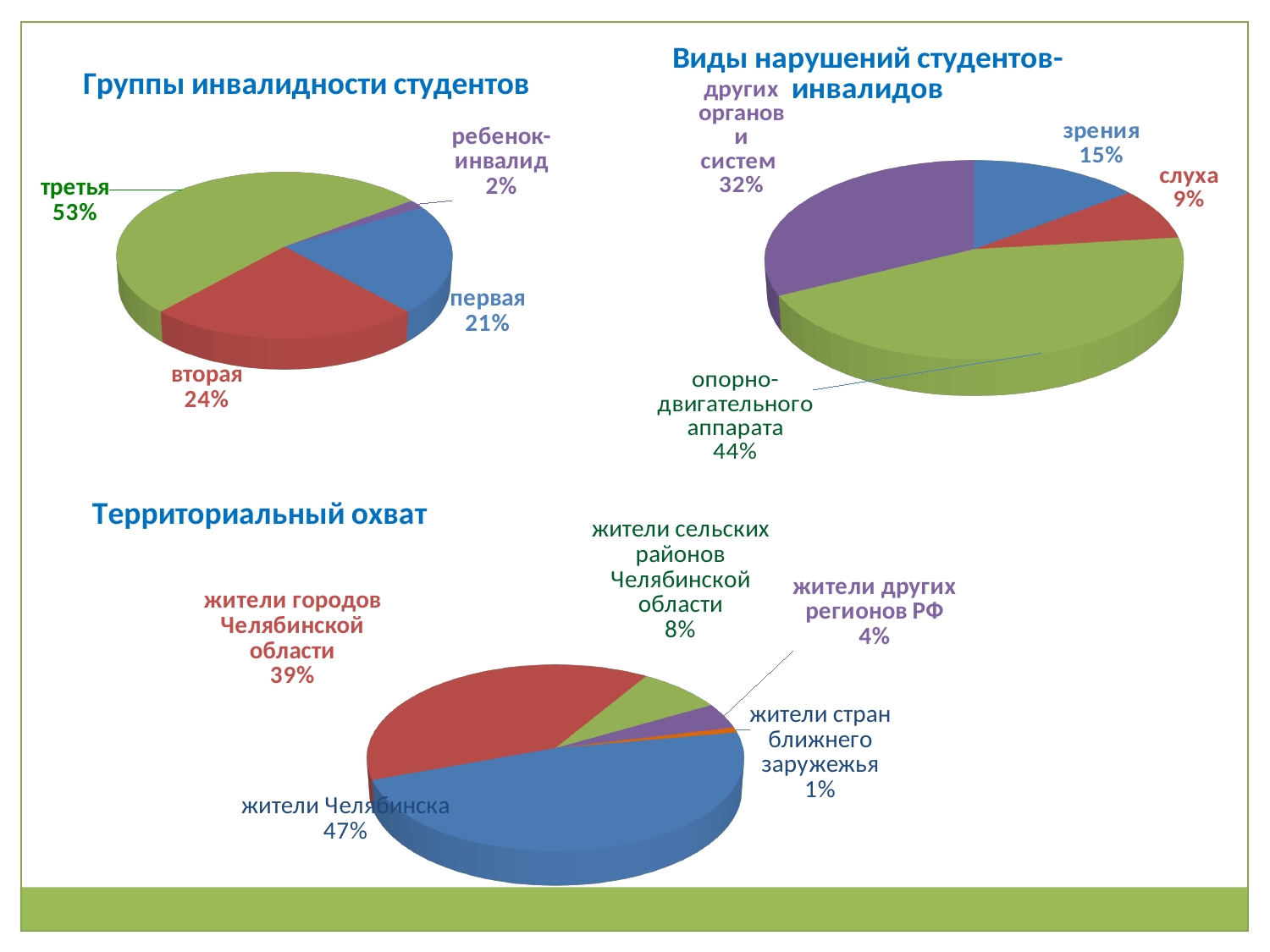
In the chart 'Виды нарушений студентов-инвалидов', which is larger: 'зрения' or 'слуха'? зрения In the chart 'Группы инвалидности студентов', which category has the smallest share? ребенок-инвалид How many categories does the chart 'Группы инвалидности студентов' show? 4 How many categories does the chart 'Территориальный охват' show? 5 In the chart 'Виды нарушений студентов-инвалидов', what is the difference between 'других органов и систем' and 'зрения'? 17% In the chart 'Территориальный охват', what share do 'жители Челябинска' have? 47% In the chart 'Виды нарушений студентов-инвалидов', which category has the largest share? опорно-двигательного аппарата In the chart 'Виды нарушений студентов-инвалидов', what share does 'опорно-двигательного аппарата' have? 44% In the chart 'Территориальный охват', which category has the smallest share? жители стран ближнего заружежья In the chart 'Группы инвалидности студентов', what share does 'третья' have? 53% What type of chart is 'Территориальный охват'? pie chart In the chart 'Группы инвалидности студентов', what is the difference between 'вторая' and 'первая'? 3%